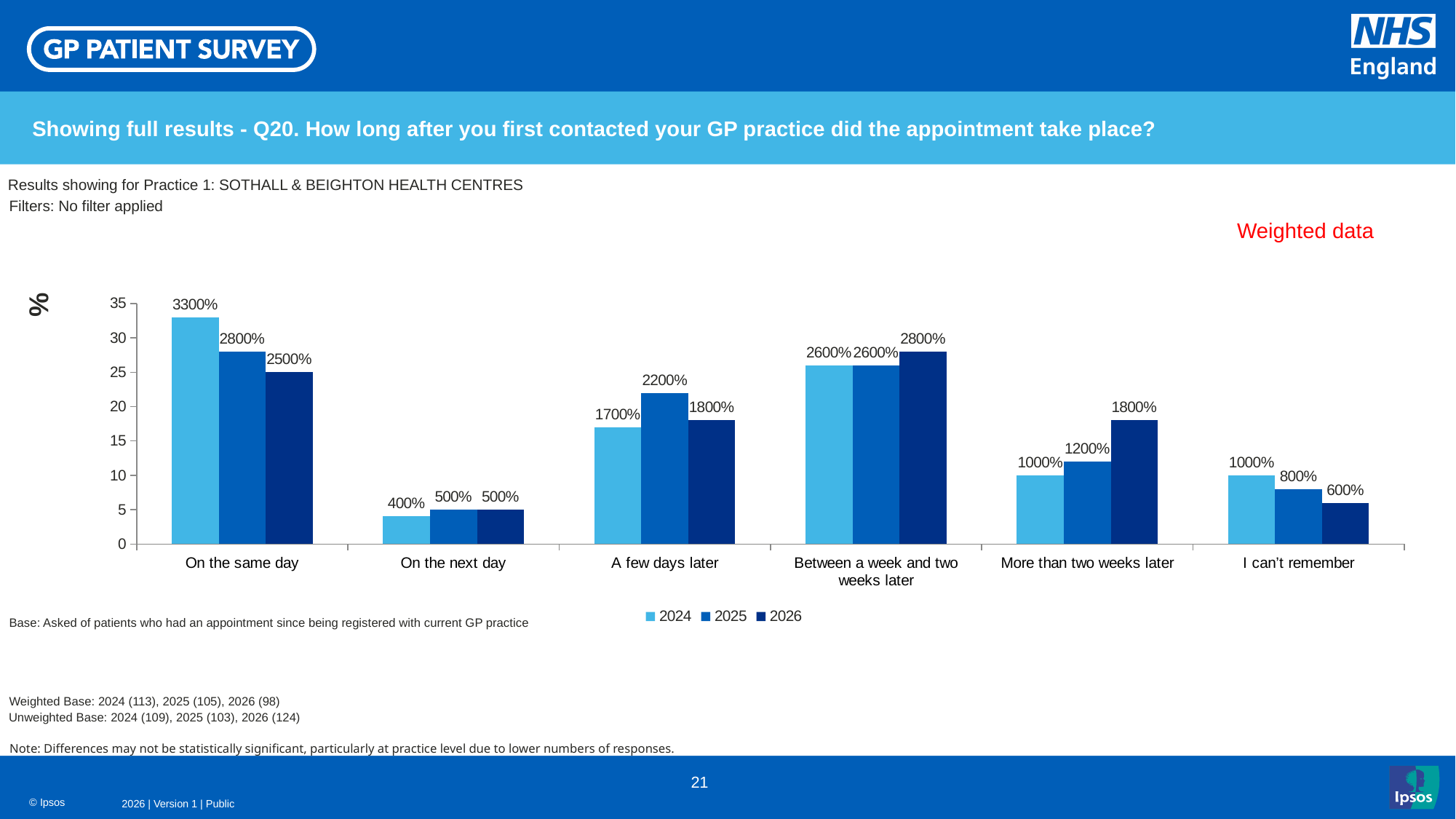
Which is larger for 'Between a week and two weeks later': the 2025 value or the 2026 value? 2026 Which category has the highest value for 2024? On the same day What kind of chart is shown on the slide? Bar chart What is the difference between the 2024 and 2026 values for 'On the same day'? 800% What is the value for 2024 for 'On the same day'? 3300% How many series does the legend list? 3 Which category has the lowest value for 2026? On the next day What is the value for 2025 for 'A few days later'? 2200% Do the values for 'On the same day' rise or fall from 2024 to 2026? Fall What is the value for 2026 for 'More than two weeks later'? 1800% What is the value for 2026 for 'I can't remember'? 600% How many categories are shown on the x axis? 6